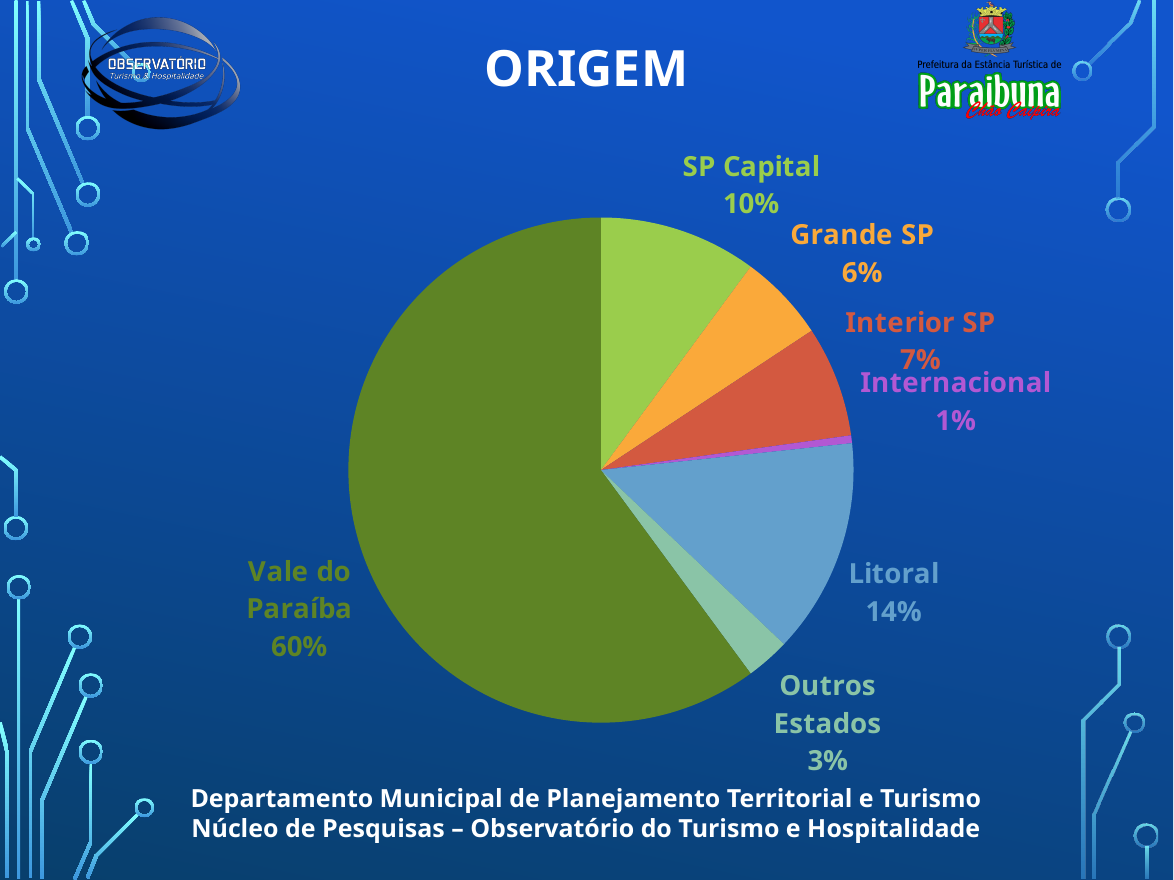
What share of the pie does Vale do Paraíba represent? 60% What is the difference between the values for Litoral and SP Capital? 4% What kind of chart is shown on the slide? Pie chart What is the value shown for Litoral? 14% What is the difference between the values for Interior SP and Grande SP? 1% What is the value shown for Internacional? 1% Which category has the smallest slice of the pie? Internacional Which is larger, Grande SP or Outros Estados? Grande SP How many categories are shown in the pie chart? 7 What is the title of the chart? ORIGEM What is the value shown for SP Capital? 10% Which category has the largest slice of the pie? Vale do Paraíba